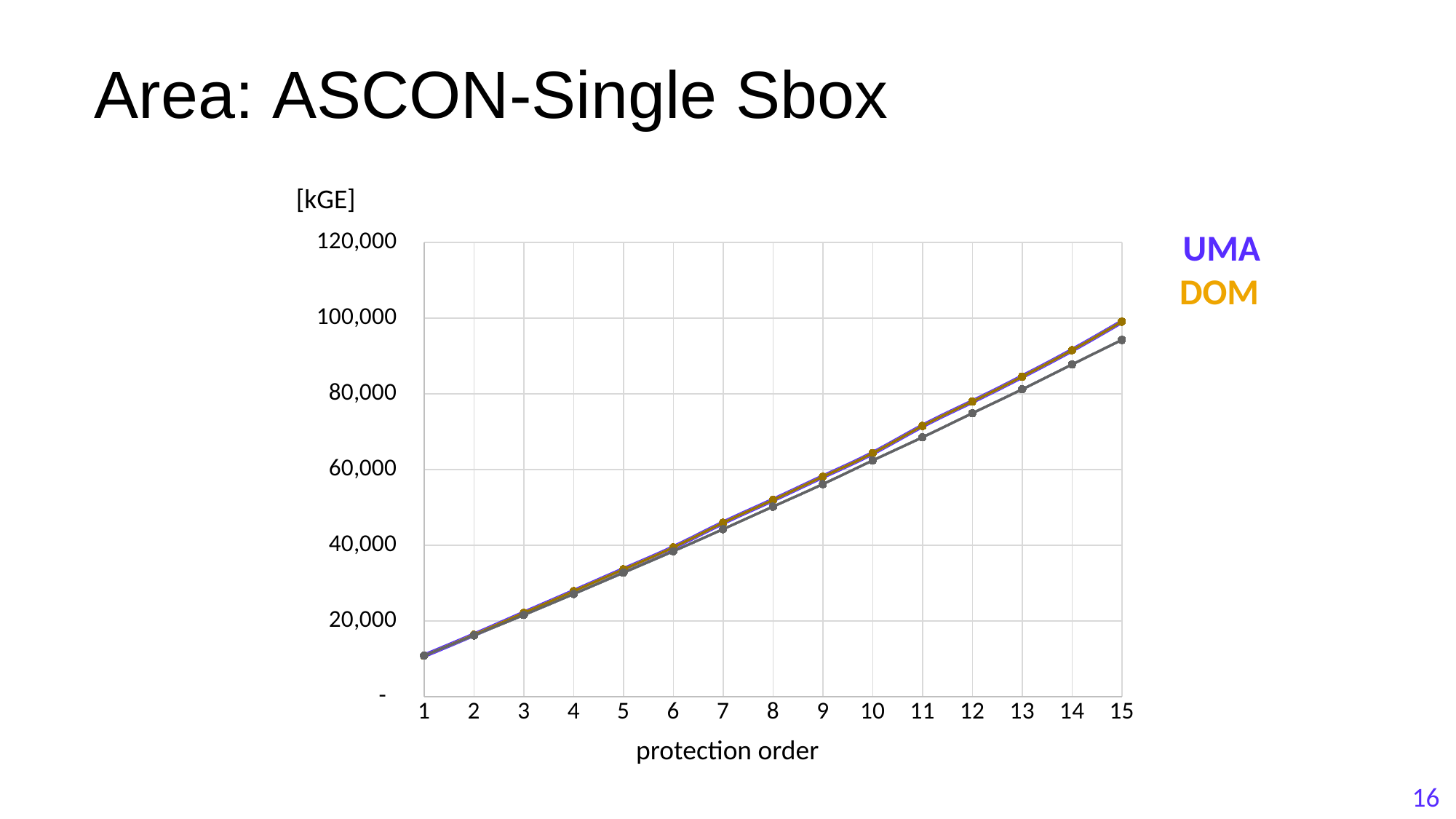
Do the DOM values rise or fall as the protection order increases? rise How many series does the legend list? 2 Is the UMA value at protection order 13 greater or less than 80,000? greater At which protection order is the DOM value highest? 15 At which protection order is the UMA value lowest? 1 What is the label of the x axis? protection order How many protection orders are plotted along the x axis? 15 Is the DOM value at protection order 1 greater or less than 20,000? less Is the UMA value at protection order 5 greater or less than 40,000? less What kind of chart is shown on the slide? line chart What unit is shown for the y axis? [kGE]